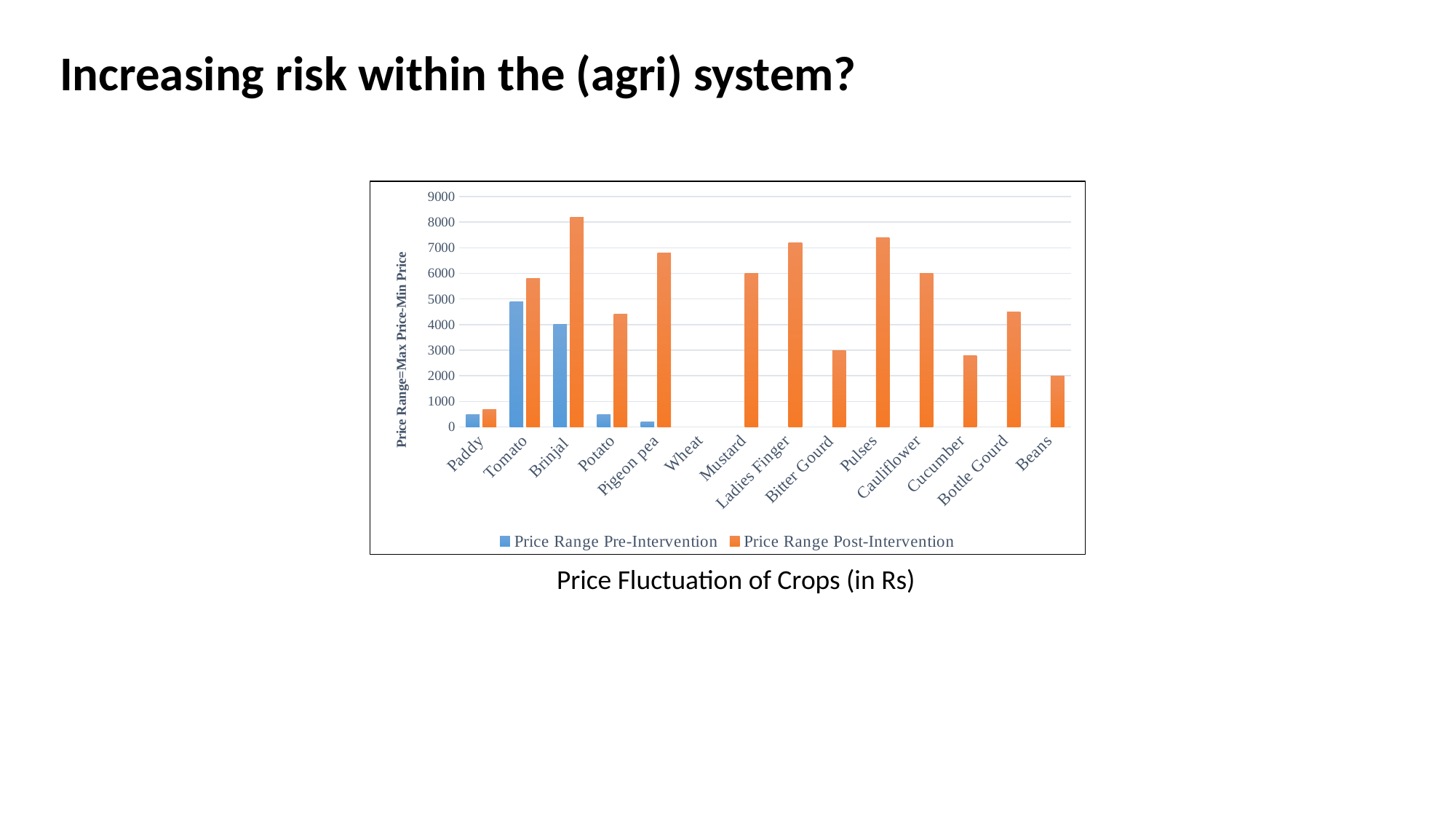
Which crop has the highest Price Range Post-Intervention? Brinjal Which is larger, the Price Range Pre-Intervention for Tomato or for Brinjal? Tomato How many crop categories are shown on the x axis? 14 Is the Price Range Post-Intervention for Cucumber greater or less than 3000? less Is the Price Range Pre-Intervention for Tomato greater or less than 4000? greater Which crop has the highest Price Range Pre-Intervention? Tomato How many series does the legend list? 2 What kind of chart is shown on the slide? bar chart Which is larger, the Price Range Post-Intervention for Pigeon pea or for Potato? Pigeon pea What is the label of the y axis? Price Range=Max Price-Min Price Is the Price Range Post-Intervention for Pulses greater or less than 7000? greater